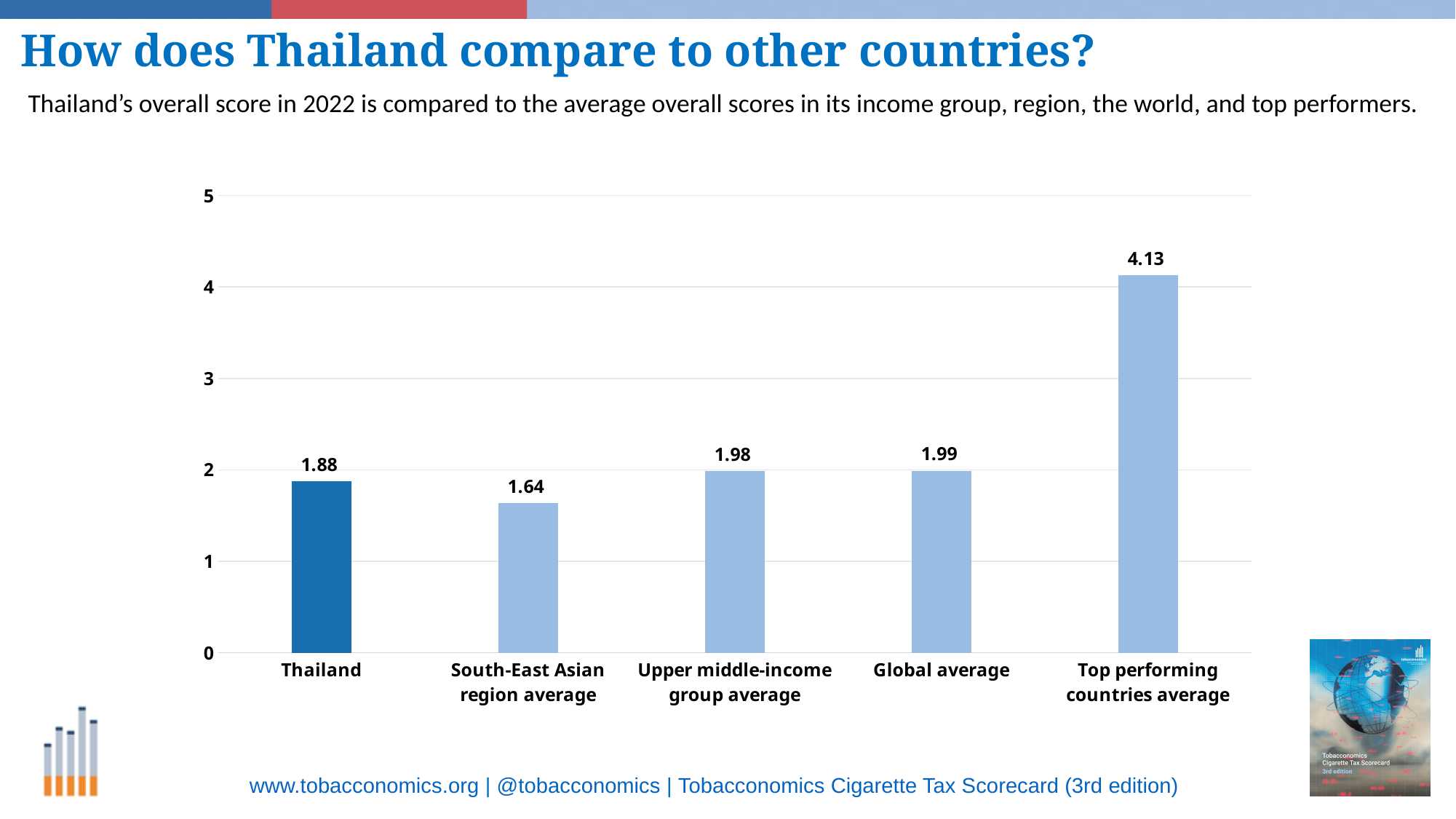
What kind of chart is shown on the slide? Bar chart Is the value for the Top performing countries average greater or less than 4? greater What is the difference between the Top performing countries average and Thailand's score? 2.25 Which category has the highest value? Top performing countries average Which is larger, Thailand's score or the Upper middle-income group average? Upper middle-income group average What is the overall score shown for Thailand? 1.88 What is the value for the South-East Asian region average? 1.64 Which category has the lowest value? South-East Asian region average What is the difference between Thailand's score and the South-East Asian region average? 0.24 How many categories are shown on the chart? 5 What is the value for the Top performing countries average? 4.13 What is the value for the Global average? 1.99